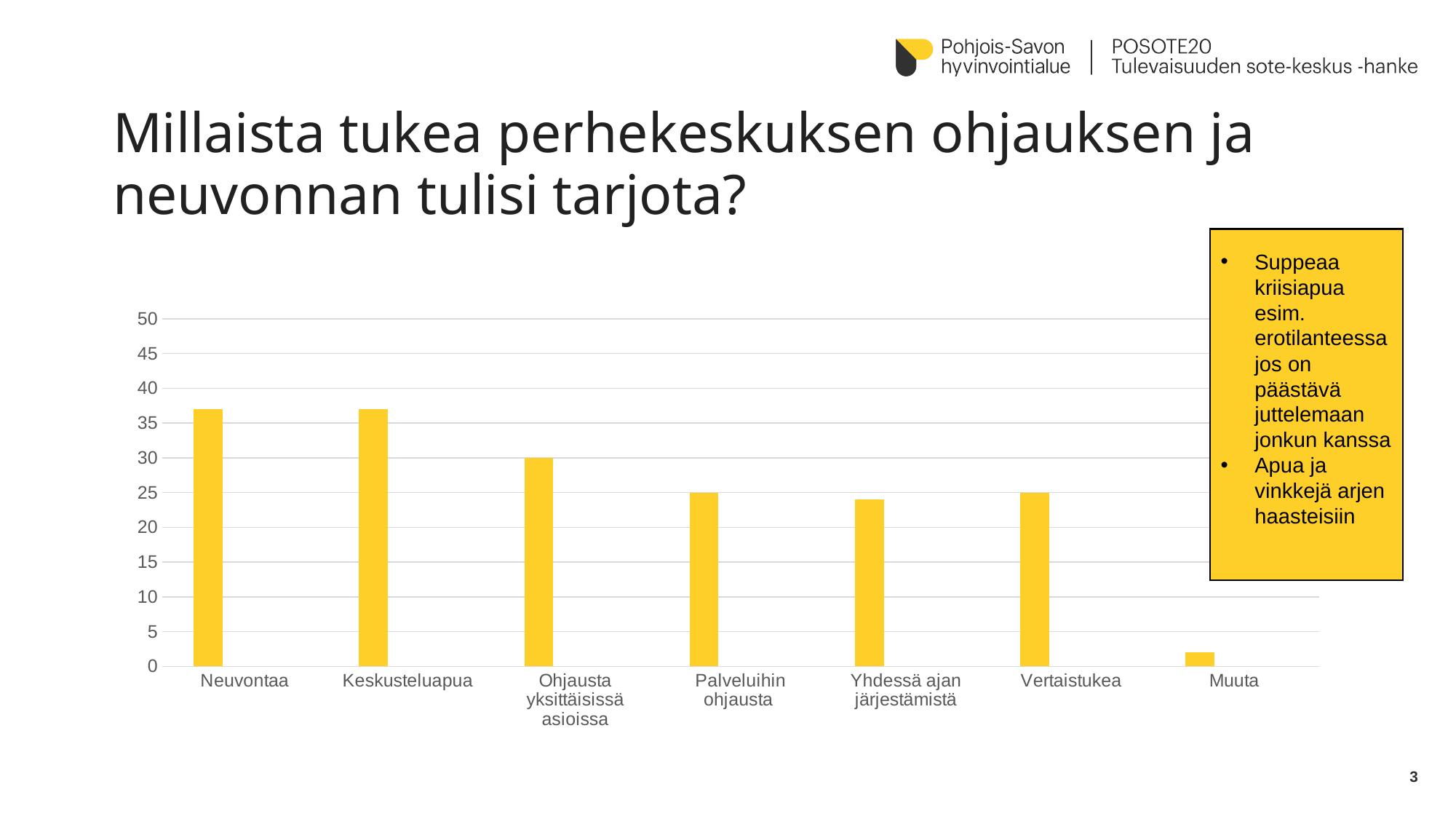
What is the value for Palveluihin ohjausta? 25 Which category has the lowest value in the chart? Muuta How many categories are shown on the x axis of the chart? 7 Do the values generally rise or fall from left to right along the x axis? fall Is the value for Neuvontaa greater or less than 35? greater What kind of chart is shown on the slide? bar chart Is the value for Muuta greater or less than 5? less Which is larger, the value for Keskusteluapua or the value for Ohjausta yksittäisissä asioissa? Keskusteluapua What is the value for Vertaistukea? 25 Is the value for Yhdessä ajan järjestämistä greater or less than 20? greater What is the value for Ohjausta yksittäisissä asioissa? 30 What colour are the bars in the chart? yellow